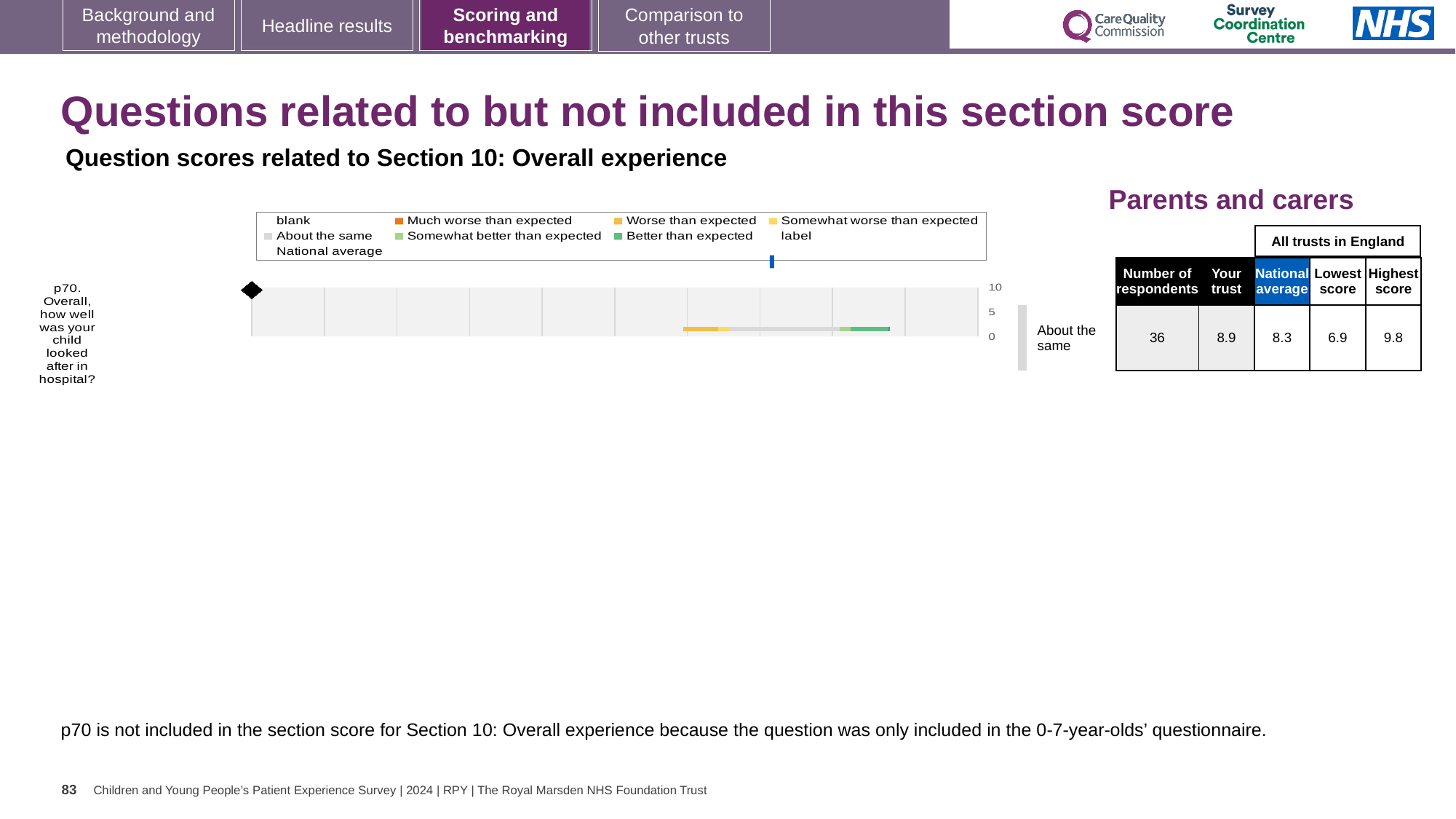
In the table beside the chart, what is the 'Your trust' score for p70? 8.9 Which is larger for p70: the 'Your trust' score or the National average? Your trust In the table beside the chart, how many respondents answered p70? 36 Which question is plotted in the chart? p70. Overall, how well was your child looked after in hospital? In the table beside the chart, what is the Lowest score among all trusts in England for p70? 6.9 In the table beside the chart, what is the National average score for p70? 8.3 What kind of chart is shown for question p70? bar chart What is the difference between the Highest score and the Lowest score for p70 in the table beside the chart? 2.9 What is the highest tick value shown on the chart's axis? 10 In the table beside the chart, what is the Highest score among all trusts in England for p70? 9.8 How many questions (categories) are plotted in the chart? 1 What benchmark category is shown next to the bar for p70? About the same